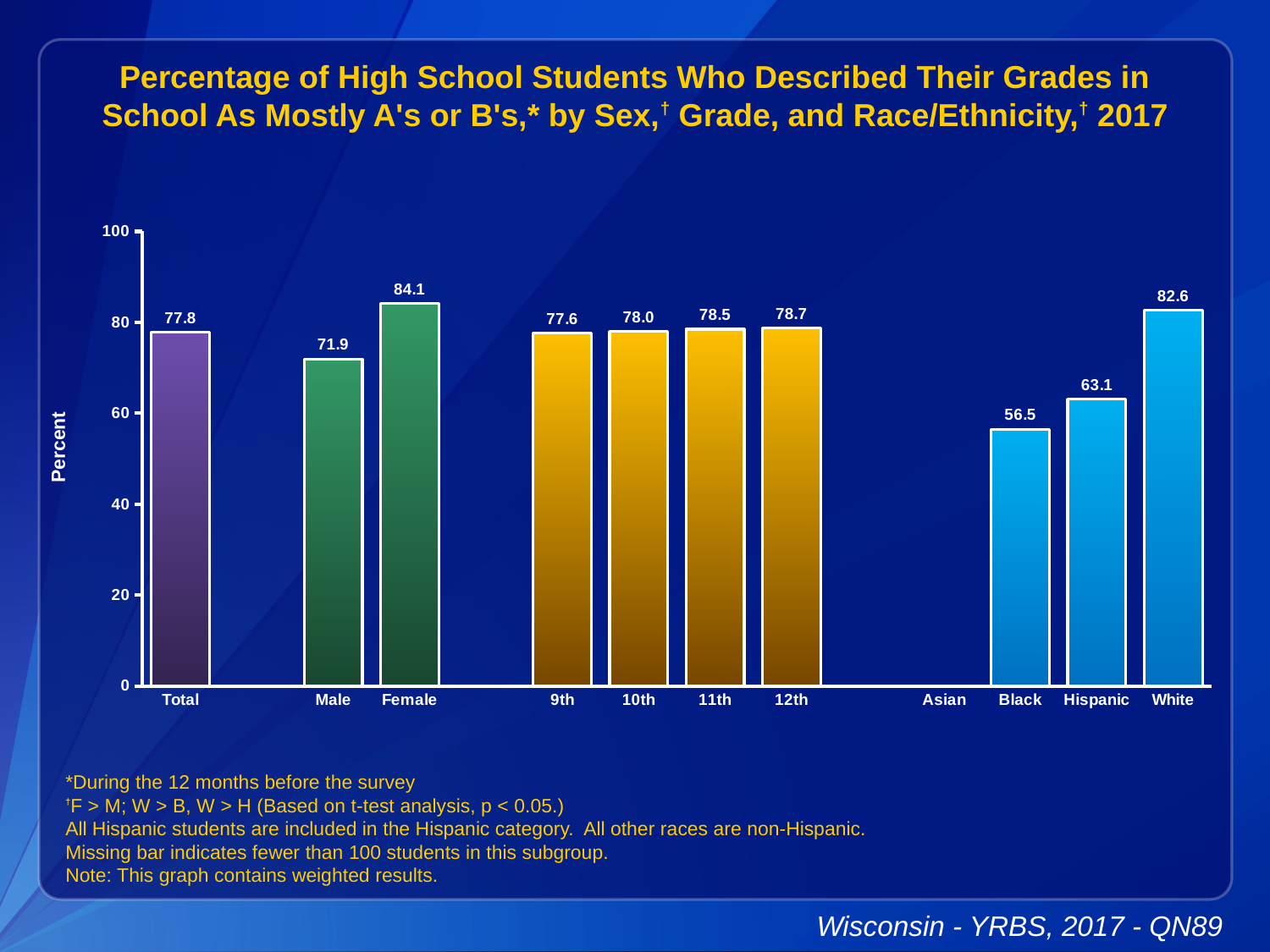
How many categories have a bar plotted? 11 Is the value for Hispanic greater or less than 60? greater What is the difference between the Female and Male values? 12.2 What is the value for Female? 84.1 What is the value for 10th grade? 78.0 What is the value for Black? 56.5 Which is larger, the value for Total or the value for Male? Total Which category has the lowest value among those with a bar? Black Do the values rise or fall from 9th grade to 12th grade? Rise What is the difference between the White and Hispanic values? 19.5 Which category has the highest value? Female What kind of chart is shown? Bar chart